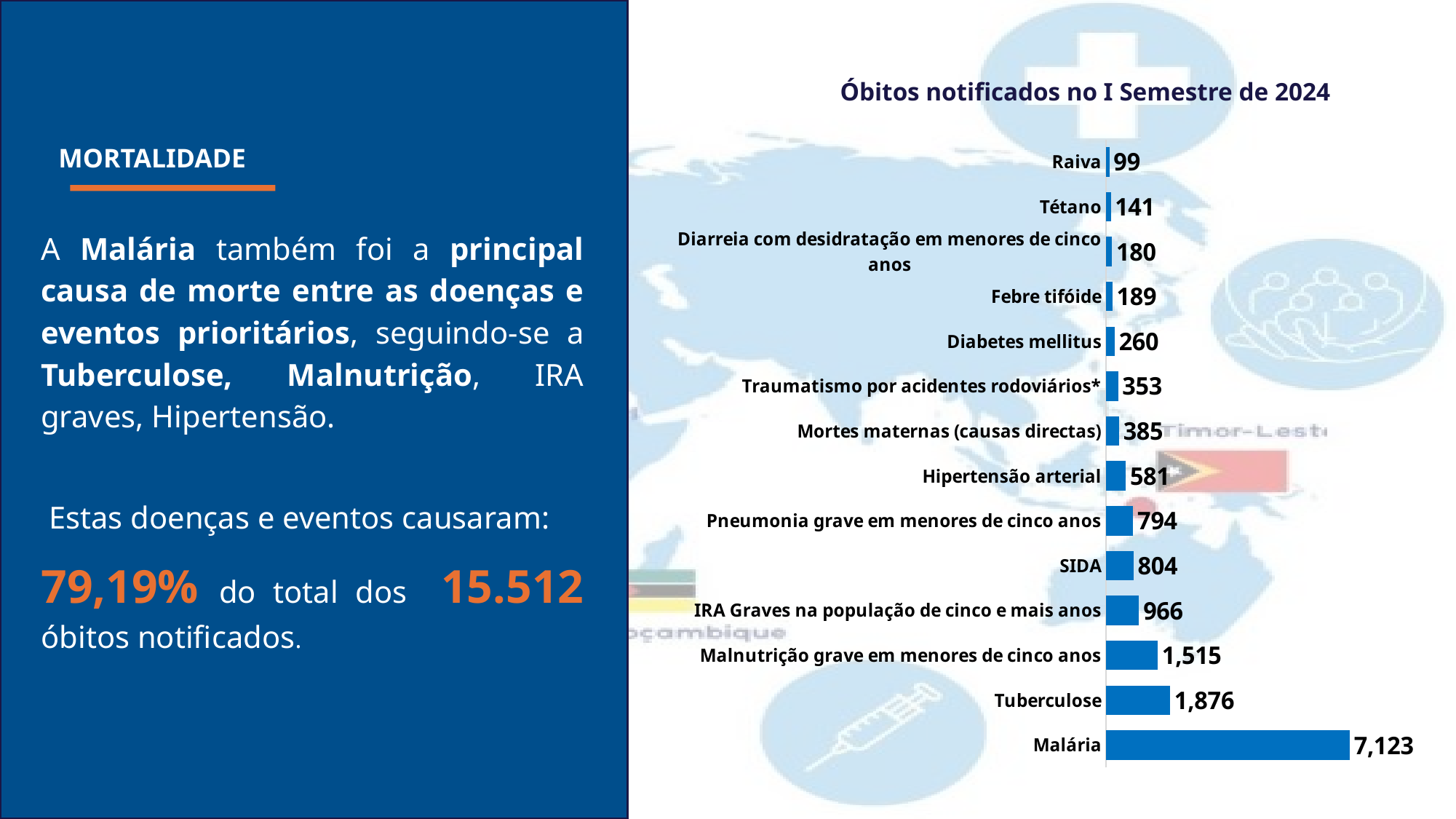
Which is larger, the value for IRA Graves na população de cinco e mais anos or the value for Diabetes mellitus? IRA Graves na população de cinco e mais anos What is the value for Malária? 7,123 What is the difference between the values for Malária and Tuberculose? 5,247 Which category has the lowest value? Raiva What is the value for Hipertensão arterial? 581 What type of chart is shown on the slide? bar chart What is the difference between the values for Tuberculose and Malnutrição grave em menores de cinco anos? 361 How many categories are plotted in the chart? 14 What is the value for Diarreia com desidratação em menores de cinco anos? 180 Which category has the highest value? Malária What is the value for Tuberculose? 1,876 What is the title of the chart? Óbitos notificados no I Semestre de 2024